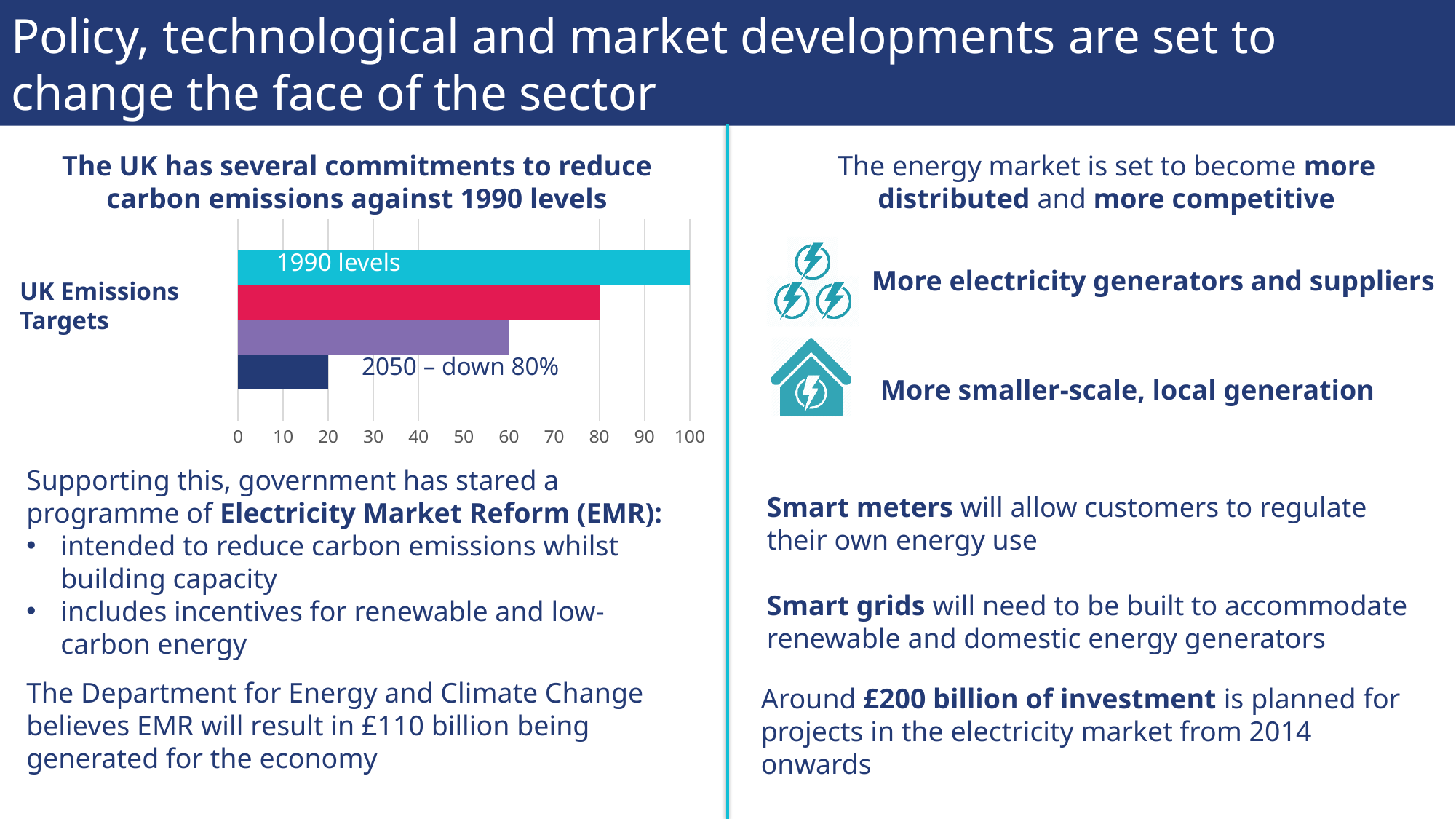
Which bar in the UK Emissions Targets chart is the shortest? 2050 – down 80% In the UK Emissions Targets chart, what is the difference between the '1990 levels' bar and the '2050 – down 80%' bar? 80 What kind of chart is shown under the heading 'The UK has several commitments to reduce carbon emissions against 1990 levels'? bar chart Which bar in the UK Emissions Targets chart is the longest? 1990 levels In the UK Emissions Targets chart, what value does the '1990 levels' bar reach on the axis? 100 How many bars does the UK Emissions Targets chart show? 4 In the UK Emissions Targets chart, is the value of the purple bar greater or less than 50? greater In the UK Emissions Targets chart, what value does the '2050 – down 80%' bar reach on the axis? 20 In the UK Emissions Targets chart, is the red bar longer or shorter than the purple bar? longer In the UK Emissions Targets chart, what value does the red bar reach on the axis? 80 What is the highest value shown on the horizontal axis of the UK Emissions Targets chart? 100 In the UK Emissions Targets chart, what value does the purple bar reach on the axis? 60